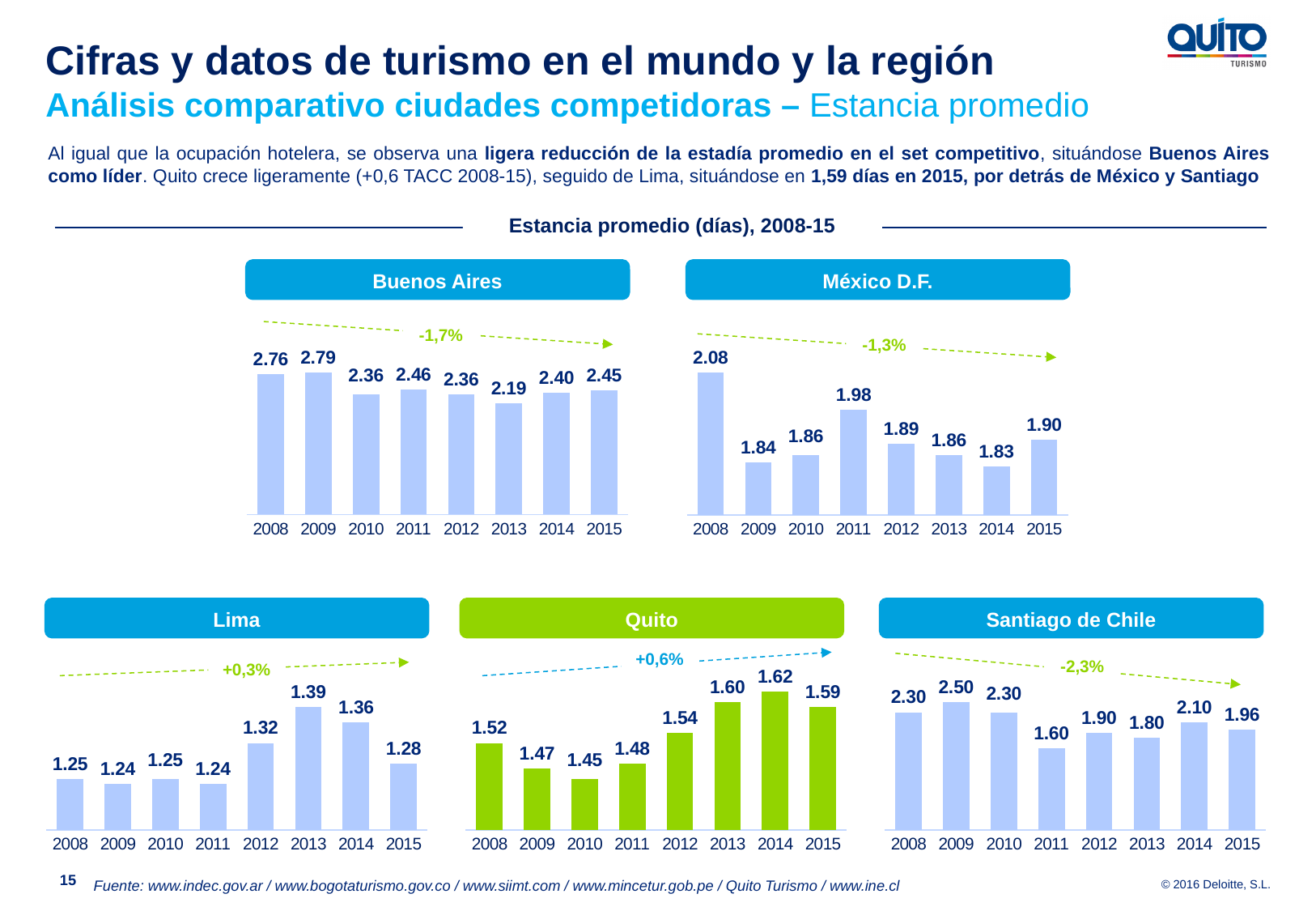
How many years are plotted in the Lima chart? 8 In the Lima chart, which year has the highest value? 2013 In the Quito chart, what is the value for 2015? 1.59 In the Quito chart, which year has the highest value? 2014 In the Santiago de Chile chart, which year has the lowest value? 2011 In the Buenos Aires chart, which is larger, the value for 2008 or the value for 2013? 2008 In the Santiago de Chile chart, what is the difference between the 2009 value and the 2011 value? 0.90 In the Buenos Aires chart, what is the average stay value for 2013? 2.19 In the México D.F. chart, what is the value for 2011? 1.98 In the Quito chart, what is the difference between the 2015 value and the 2008 value? 0.07 What growth rate (TACC) is shown above the Santiago de Chile chart? -2,3% What type of chart is used for México D.F.? Bar chart